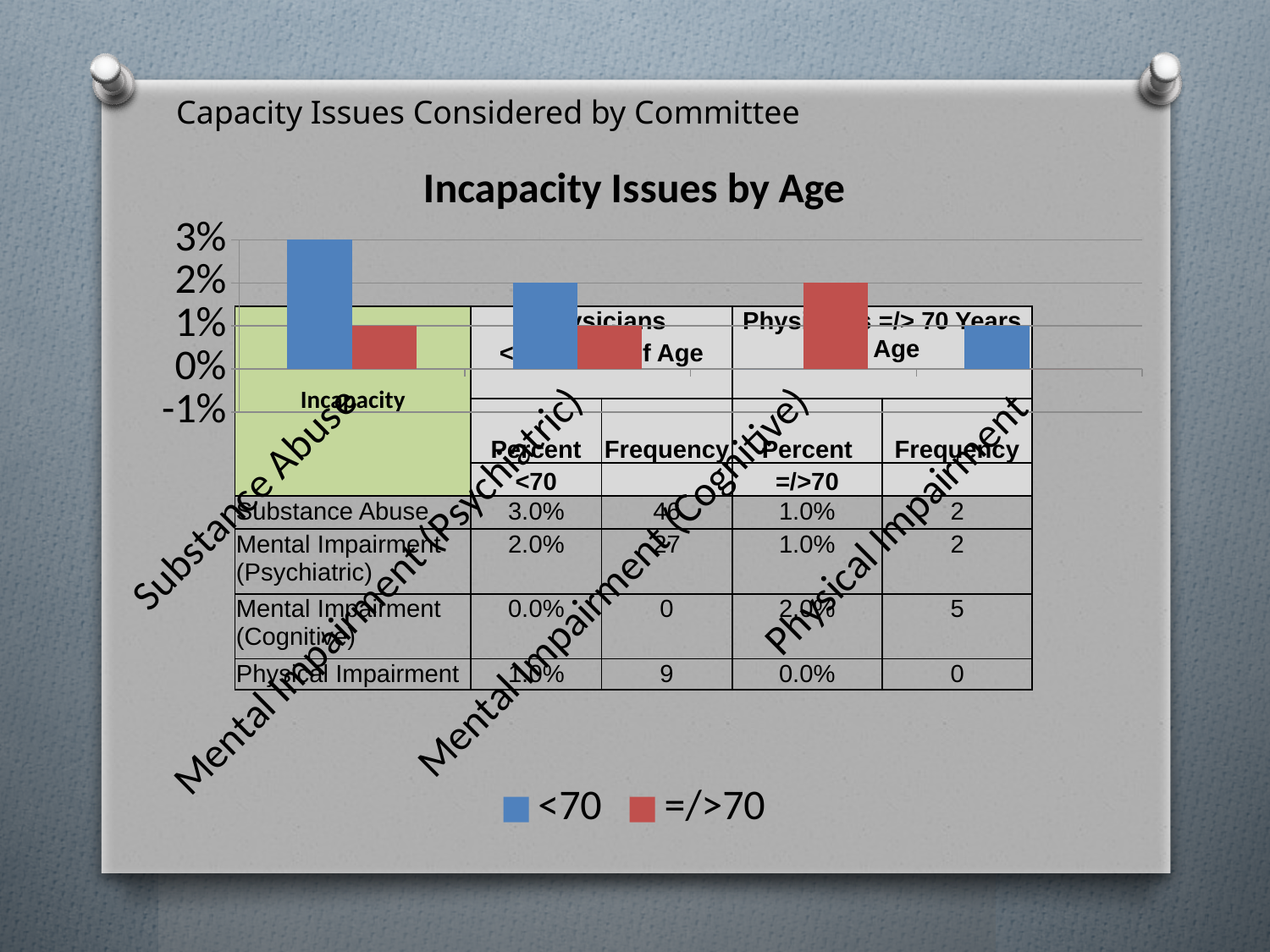
What is the difference between the <70 and =/>70 values for Substance Abuse? 2% Which category has the highest value in the <70 series? Substance Abuse What type of chart is shown on the slide? Bar chart For Substance Abuse, which series has the larger value, <70 or =/>70? <70 How many categories are plotted on the x axis of the Incapacity Issues by Age chart? 4 Which category has the highest value in the =/>70 series? Mental Impairment (Cognitive) What are the two entries in the chart's legend? <70 and =/>70 How many series does the legend of the Incapacity Issues by Age chart list? 2 What is the value for Mental Impairment (Cognitive) in the =/>70 series? 2% What is the value for Physical Impairment in the <70 series? 1% Which category has the lowest value in the =/>70 series? Physical Impairment What is the value for Substance Abuse in the <70 series? 3%